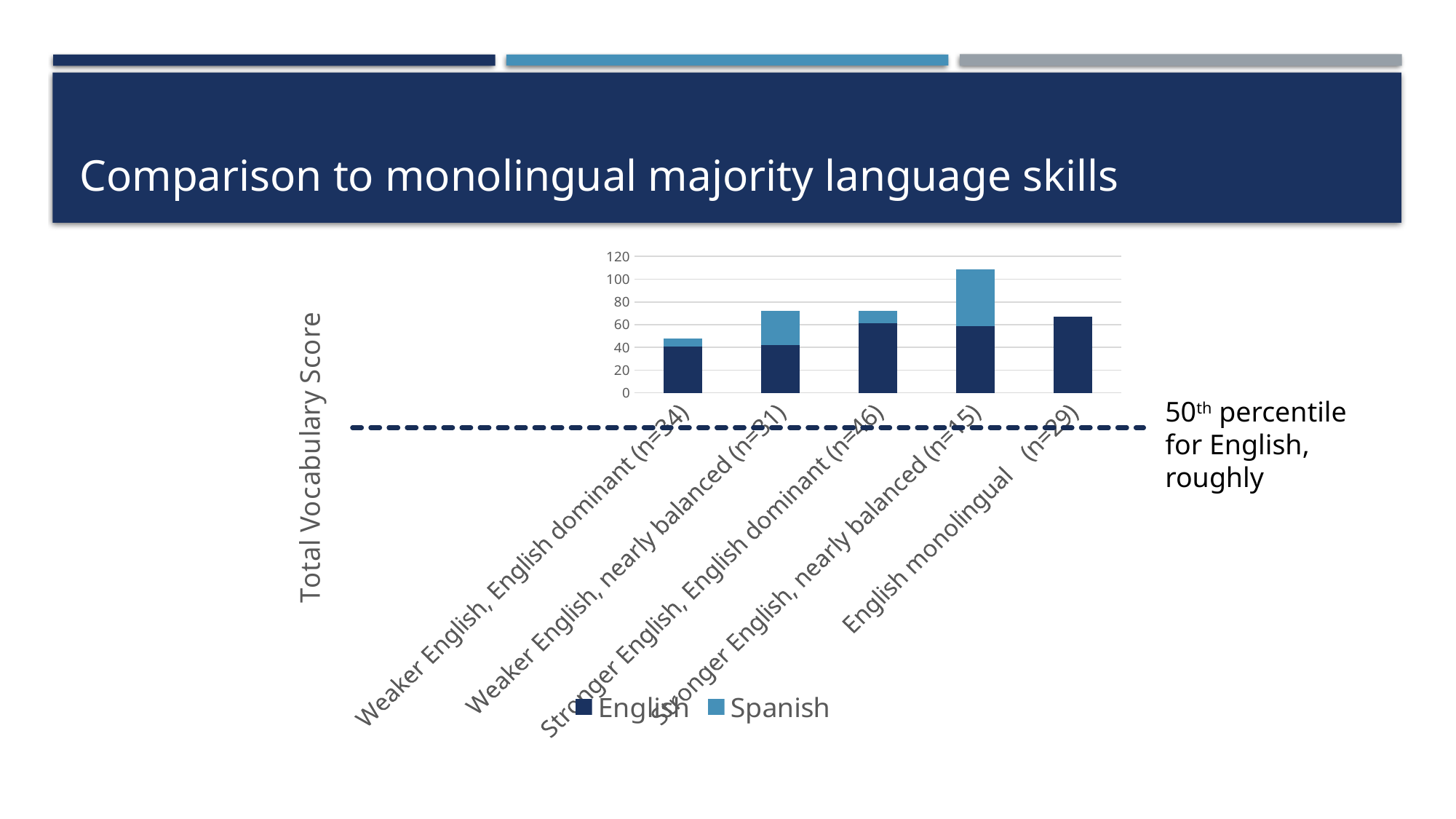
Is the English value for English monolingual (n=29) greater or less than 60? greater How many categories are shown on the x axis of the chart? 5 How many series does the chart's legend list? 2 Which has the larger Spanish segment: Weaker English, nearly balanced (n=31) or Stronger English, English dominant (n=46)? Weaker English, nearly balanced (n=31) What kind of chart is shown on the slide? Stacked bar chart Is the English value for Weaker English, nearly balanced (n=31) greater or less than 60? less Is the total stacked bar for Stronger English, nearly balanced (n=15) greater or less than 100? greater Which category has the shortest stacked bar in the chart? Weaker English, English dominant (n=34) What is the title of the chart's vertical axis? Total Vocabulary Score Which series is shown in the lighter blue colour in the chart? Spanish Which category has the tallest stacked bar in the chart? Stronger English, nearly balanced (n=15)